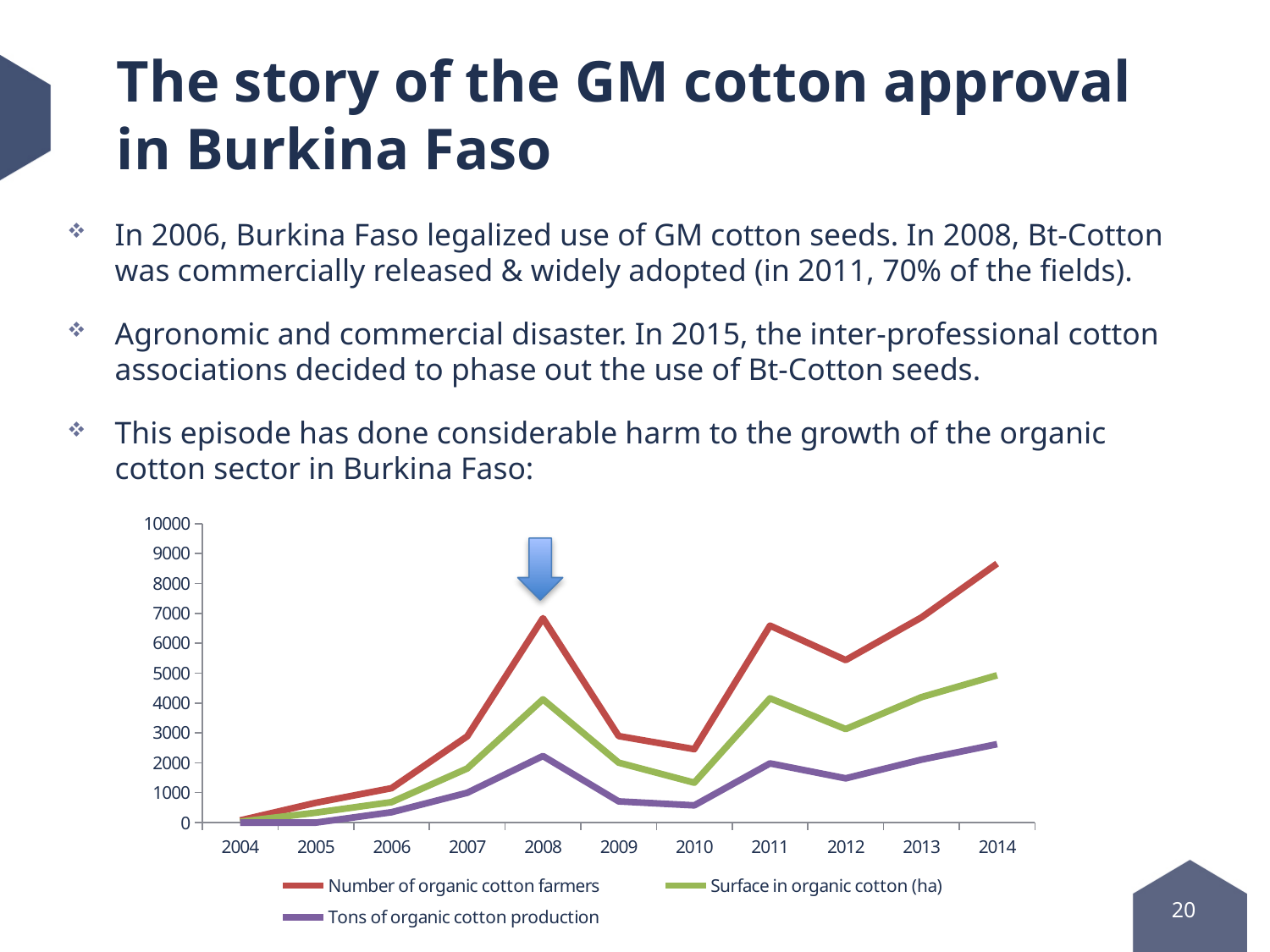
Is the number of organic cotton farmers in 2010 greater or less than 3000? less How many series does the chart legend list? 3 Is the tons of organic cotton production in 2008 greater or less than 3000? less How many years are plotted along the x axis of the chart? 11 Does the number of organic cotton farmers rise or fall from 2008 to 2010? fall Is the number of organic cotton farmers in 2008 greater or less than 6000? greater In 2012, which is larger: the number of organic cotton farmers or the surface in organic cotton (ha)? Number of organic cotton farmers Which series is drawn with the red line? Number of organic cotton farmers What kind of chart is shown on the slide? line chart In which year is the number of organic cotton farmers lowest? 2004 In which year is the number of organic cotton farmers highest? 2014